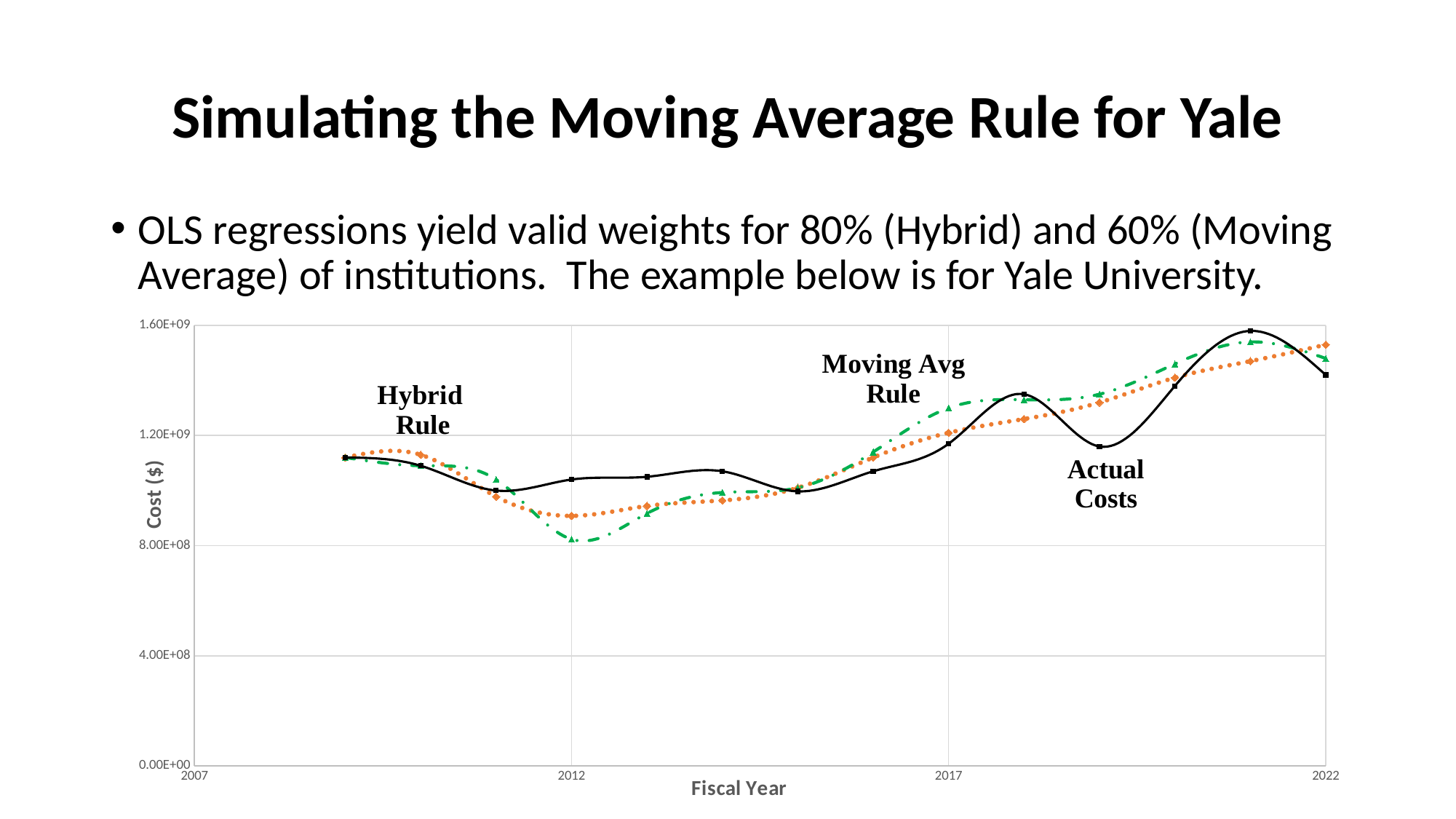
What is the title of the vertical axis of the chart? Cost ($) Which series has the lowest value in 2012? Moving Avg Rule Do the Actual Costs generally rise or fall between 2017 and 2022? rise How many data series are plotted on the chart? 3 What are the names of the three series labelled on the chart? Hybrid Rule, Moving Avg Rule, Actual Costs What kind of chart is shown on the slide? line chart In 2012, which is higher: Actual Costs or the Moving Avg Rule? Actual Costs Is the value of Actual Costs in 2012 greater or less than 1.20E+09? less Is the value of the Hybrid Rule series in 2022 greater or less than 1.20E+09? greater Is the value of Actual Costs in 2022 greater or less than 1.20E+09? greater In 2022, which is higher: the Hybrid Rule or Actual Costs? Hybrid Rule